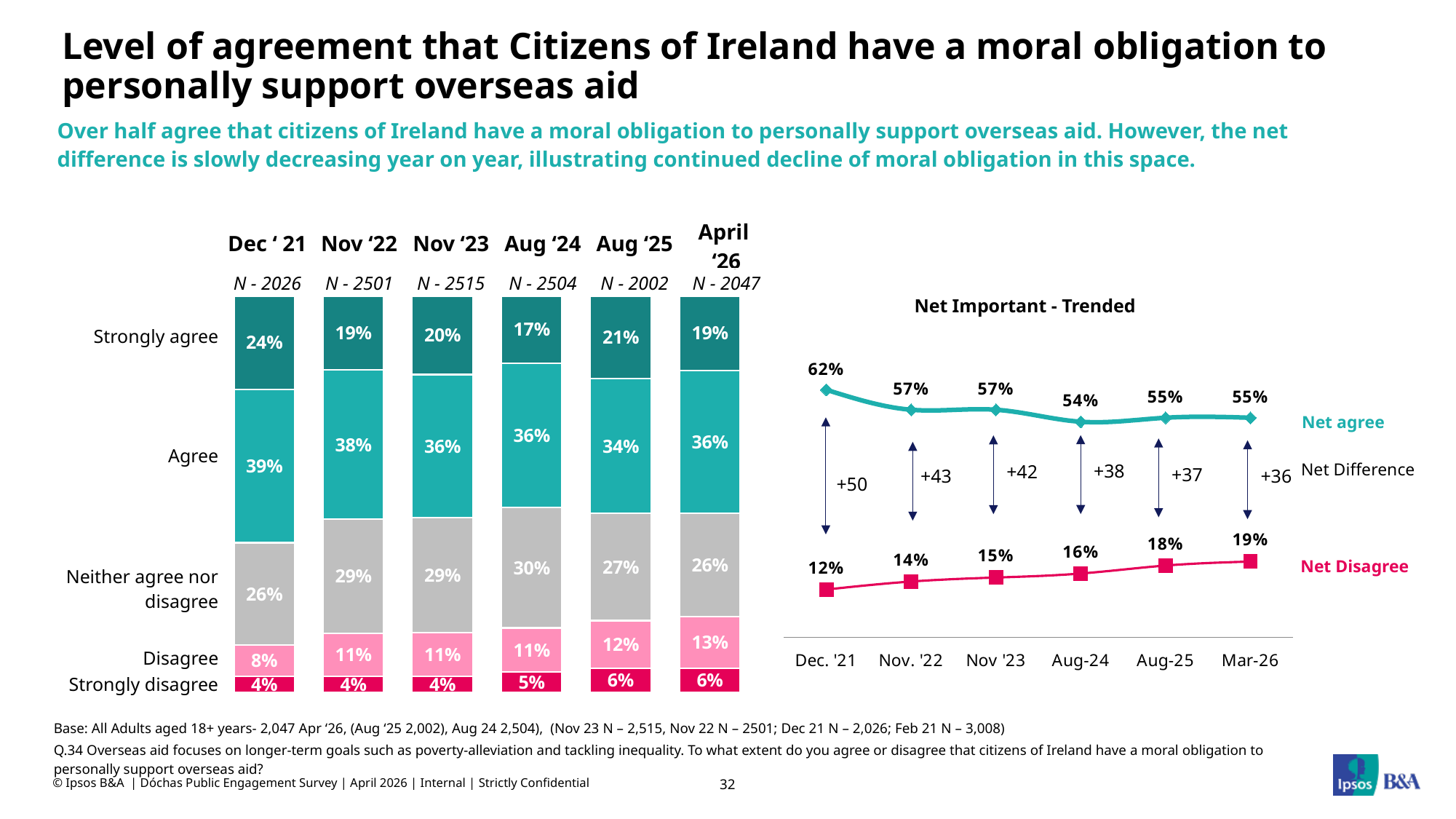
In the 'Net Important - Trended' chart, what is the Net Disagree value for Mar-26? 19% In the 'Net Important - Trended' chart, what is the Net Difference shown for Aug-24? +38 In the 'Net Important - Trended' chart, what is the Net agree value for Dec. '21? 62% In the 'Net Important - Trended' chart, does the Net Disagree line rise or fall from Dec. '21 to Mar-26? Rises In the stacked bar chart on the left, which wave has the highest 'Strongly agree' percentage? Dec '21 In the stacked bar chart on the left, how many survey waves are shown? 6 In the stacked bar chart on the left, which wave has the lowest 'Disagree' percentage? Dec '21 In the stacked bar chart on the left, what is the difference between the 'Neither agree nor disagree' percentage in Aug '24 and in Dec '21? 4 percentage points In the stacked bar chart on the left, what percentage answered 'Agree' in Aug '25? 34% In the stacked bar chart on the left, what percentage strongly agreed in Dec '21? 24% What type of chart is 'Net Important - Trended'? Line chart In the stacked bar chart on the left, what percentage answered 'Strongly disagree' in April '26? 6%